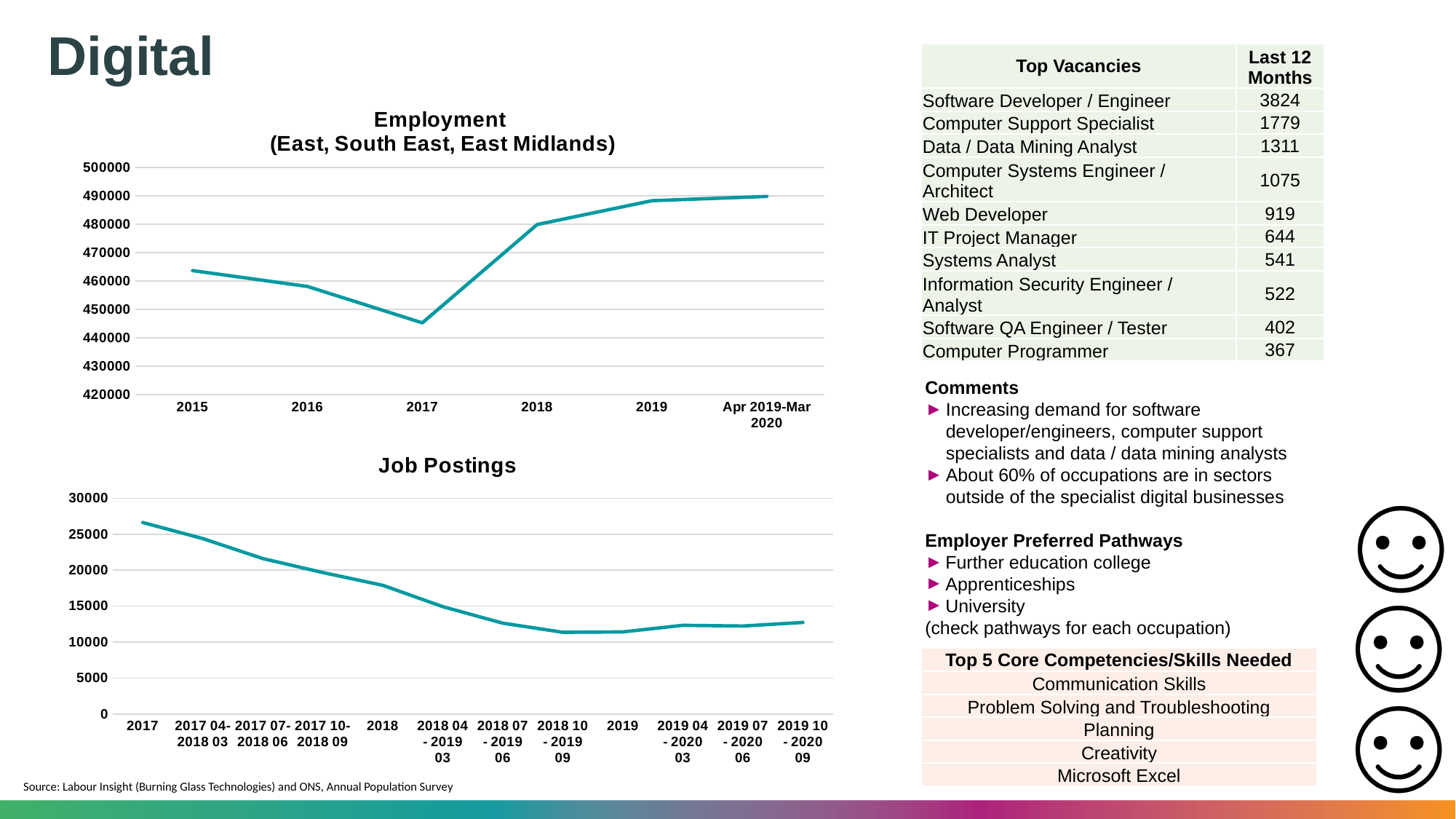
In the Employment (East, South East, East Midlands) chart, is the value for 2017 greater or less than 450000? less In the Job Postings chart, which period has the highest number of job postings? 2017 In the Job Postings chart, is the value for 2017 greater or less than 25000? greater In the Employment (East, South East, East Midlands) chart, which is larger, the value for 2016 or the value for 2017? 2016 How many periods are plotted on the x axis of the Employment (East, South East, East Midlands) chart? 6 What kind of chart is the Job Postings chart? line chart What kind of chart is the Employment (East, South East, East Midlands) chart? line chart In the Employment (East, South East, East Midlands) chart, which period has the lowest employment? 2017 In the Job Postings chart, is the value for 2019 10 - 2020 09 greater or less than 15000? less In the Job Postings chart, do the values rise or fall from 2017 to 2019? fall How many periods are plotted on the x axis of the Job Postings chart? 12